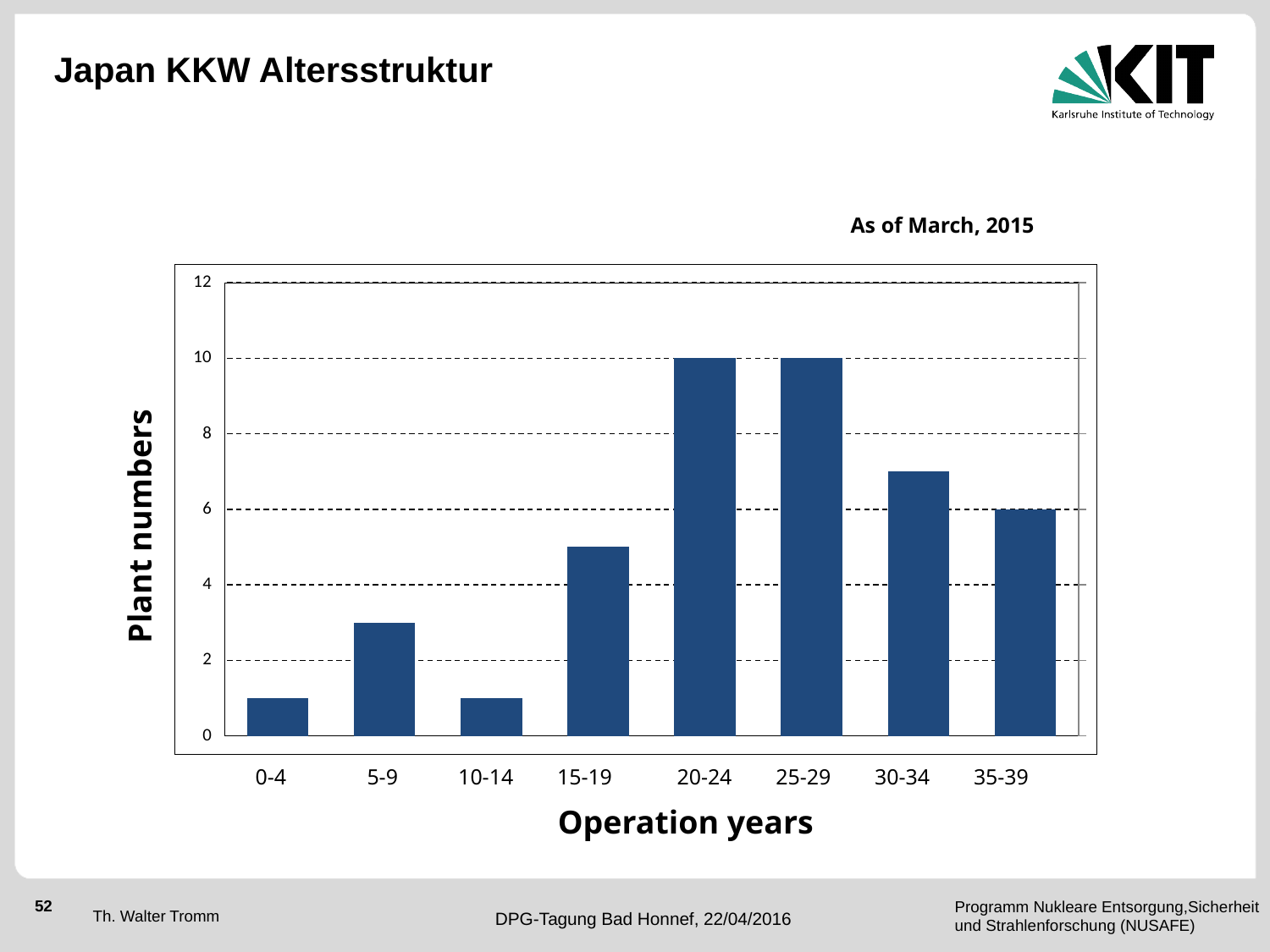
What is the difference between the plant numbers for 20-24 and 35-39 operation years? 4 How many operation-year categories are shown on the x axis? 8 Do the plant numbers rise or fall from the 25-29 category to the 35-39 category? fall What kind of chart is shown on the slide? bar chart What is the plant number for the 25-29 operation years category? 10 Is the value for the 30-34 operation years category greater or less than 6? greater Is the value for the 15-19 operation years category greater or less than 4? greater Is the value for the 0-4 operation years category greater or less than 2? less What is the plant number for the 20-24 operation years category? 10 Which has a larger plant number, the 5-9 or the 15-19 operation years category? 15-19 What is the label of the y axis? Plant numbers What is the plant number for the 35-39 operation years category? 6